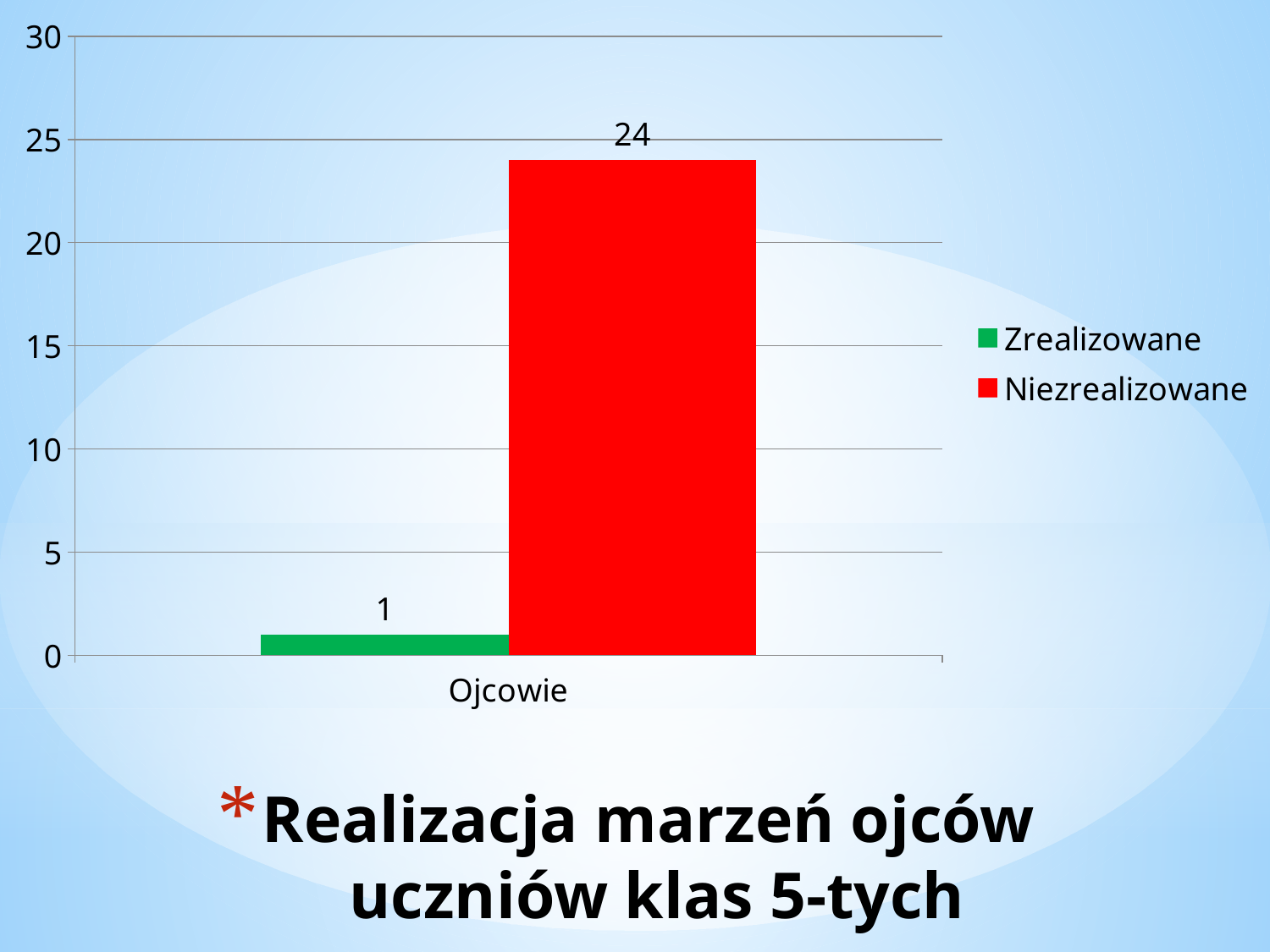
What kind of chart is shown on the slide? bar chart Which series has the lowest value on the chart? Zrealizowane What is the value of Zrealizowane for Ojcowie? 1 What colour is the Niezrealizowane bar? red Is the value for Niezrealizowane greater or less than 20? greater Which series has the higher value for Ojcowie, Zrealizowane or Niezrealizowane? Niezrealizowane What is the difference between the Niezrealizowane and Zrealizowane values for Ojcowie? 23 Is the value for Zrealizowane greater or less than 5? less What is the value of Niezrealizowane for Ojcowie? 24 What is the category label on the x axis? Ojcowie How many series does the legend list? 2 How many categories are shown on the x axis? 1